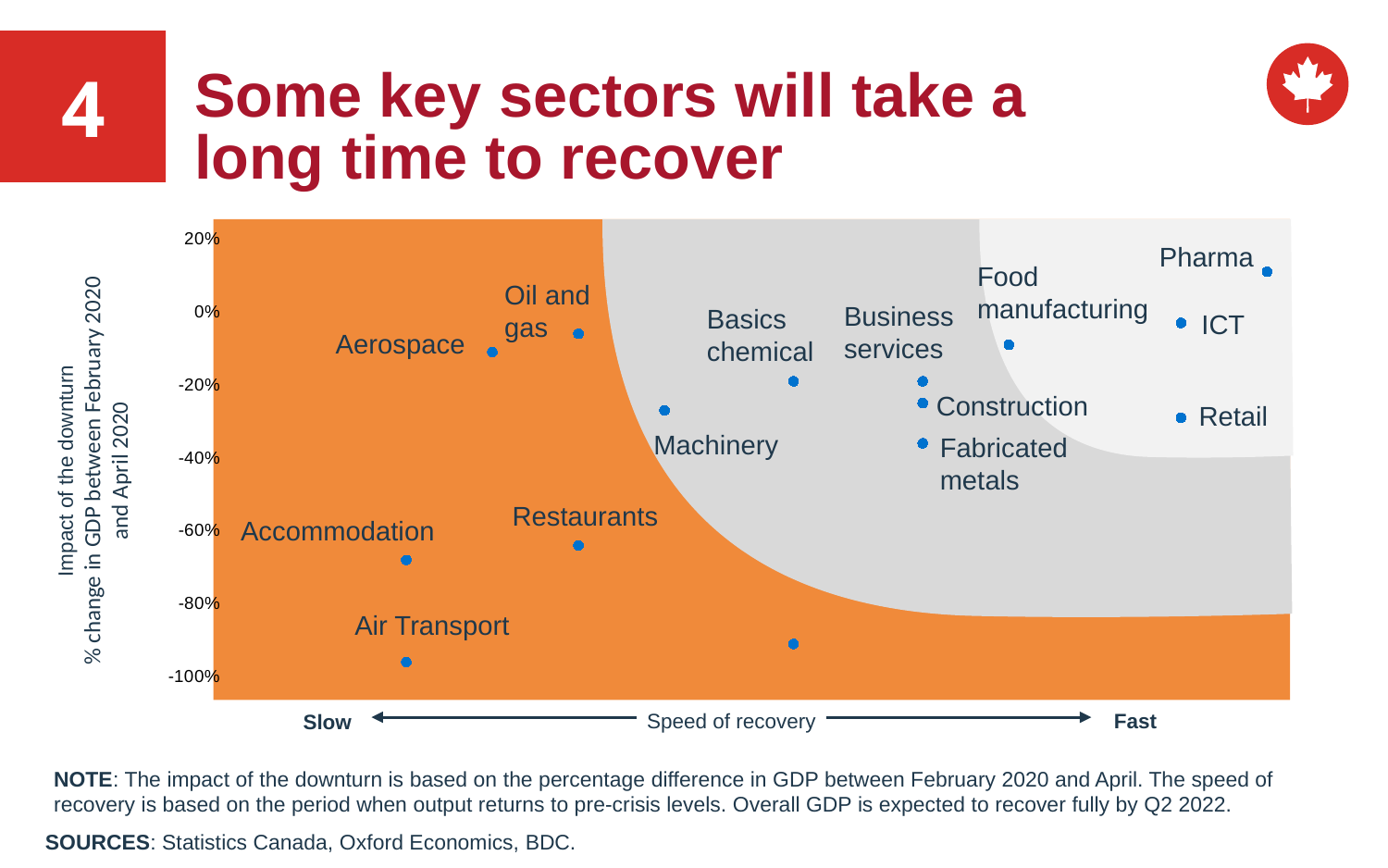
Is the impact of the downturn value for Accommodation greater or less than -60%? less Is the impact of the downturn value for Food manufacturing greater or less than -20%? greater Is the impact of the downturn value for Pharma greater or less than 0%? greater Which sector has a higher impact of the downturn value, Aerospace or Accommodation? Aerospace Which sector has the lowest impact of the downturn value on the chart? Air Transport Which sector is positioned furthest to the right (fastest speed of recovery) on the chart? Pharma What does the horizontal axis of the chart represent? Speed of recovery How many labeled sectors are plotted on the chart? 14 Which sector has the highest (least negative) impact of the downturn on the chart? Pharma What kind of chart is shown on the slide? Scatter chart